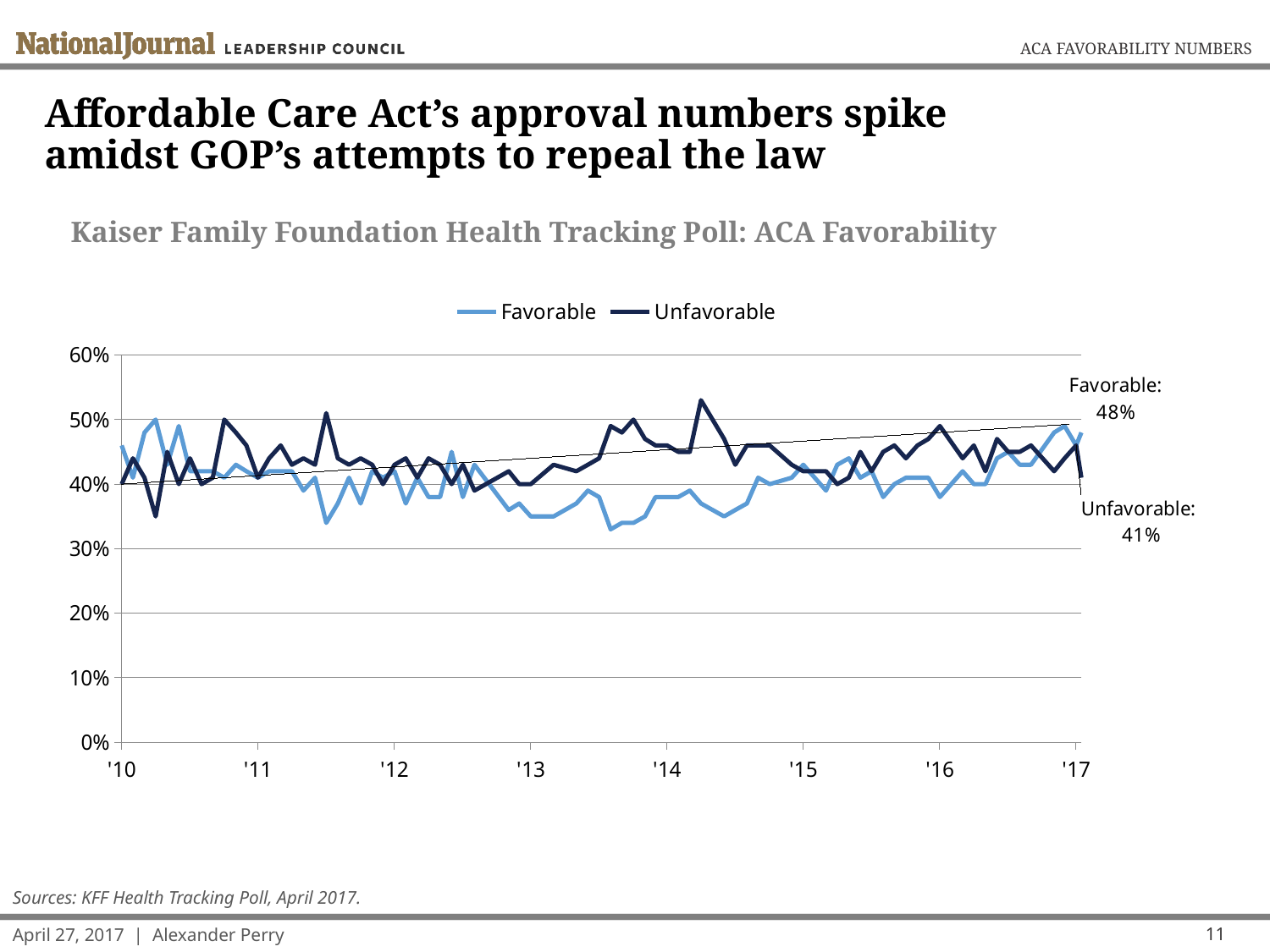
What is the final Favorable value labeled on the chart? 48% How many series does the legend list? 2 What is the final Unfavorable value labeled on the chart? 41% At the end of the chart, which is larger: the Favorable or the Unfavorable value? Favorable What kind of chart is shown on the slide? Line chart How many year labels are shown on the x axis? 8 Is the highest point of the Unfavorable line, around early 2014, greater or less than 50%? greater What is the difference between the labeled final Favorable and Unfavorable values? 7 percentage points Does the Favorable line generally rise or fall between '14 and '17? Rise Is the lowest point of the Favorable line, around late 2013, greater or less than 40%? less Which series is drawn in the lighter blue line? Favorable What is the title of the chart? Kaiser Family Foundation Health Tracking Poll: ACA Favorability